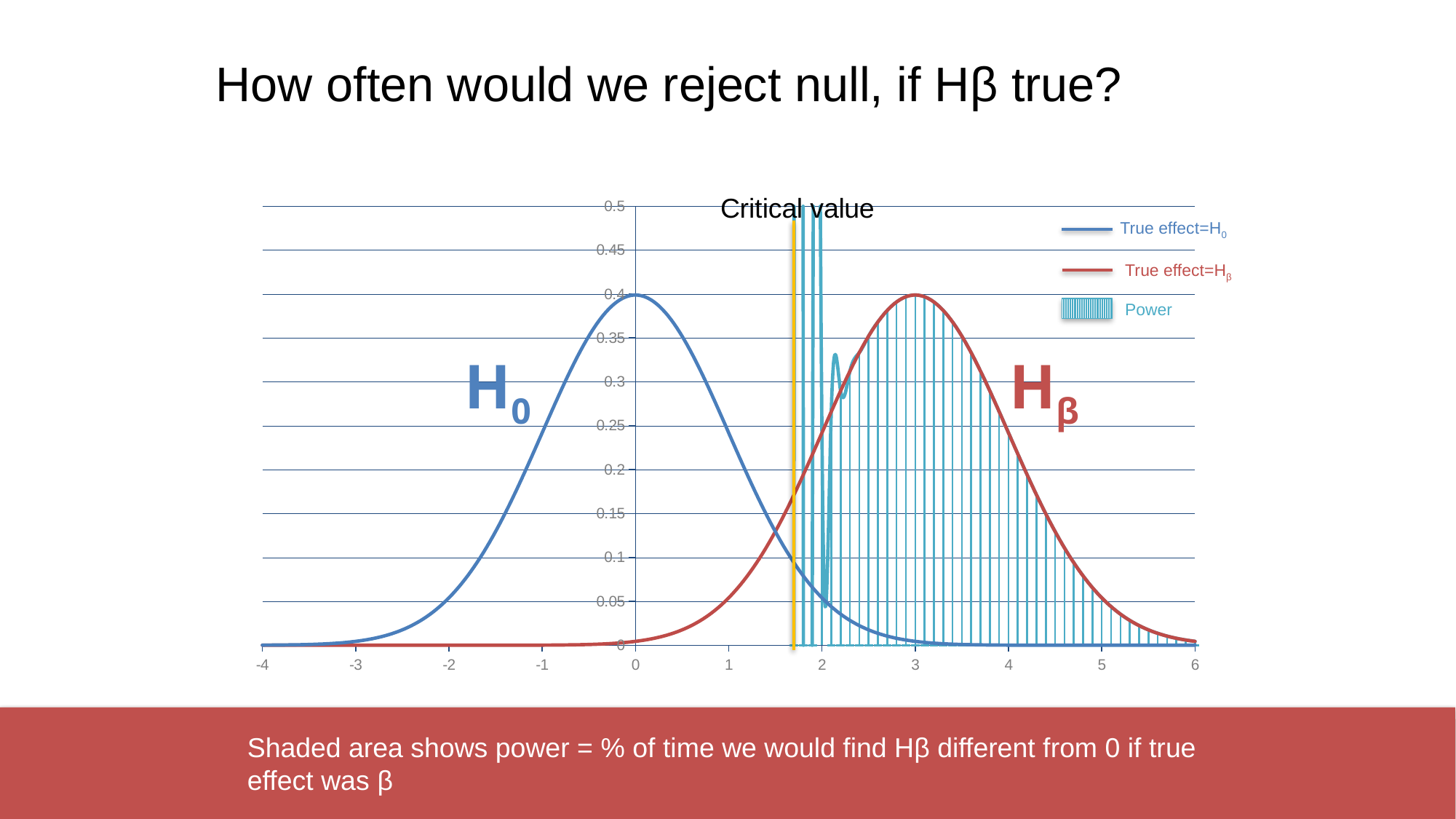
Is the value of the red 'True effect=Hβ' curve at x = 3 greater or less than 0.35? greater At x = 2, which curve is higher: the blue 'True effect=H0' curve or the red 'True effect=Hβ' curve? True effect=Hβ Is the value of the red 'True effect=Hβ' curve at x = 0 greater or less than 0.05? less Is the value of the blue 'True effect=H0' curve at x = 2 greater or less than 0.1? less What label is attached to the vertical yellow line on the chart? Critical value How many entries does the chart legend list? 3 At x = 1, which curve is higher: the blue 'True effect=H0' curve or the red 'True effect=Hβ' curve? True effect=H0 At which x-axis value does the blue 'True effect=H0' curve reach its peak? 0 What kind of chart is shown on the slide? Line chart What is the peak value of the blue 'True effect=H0' curve, as read against the y-axis gridline it touches? 0.4 At which x-axis value does the red 'True effect=Hβ' curve reach its peak? 3